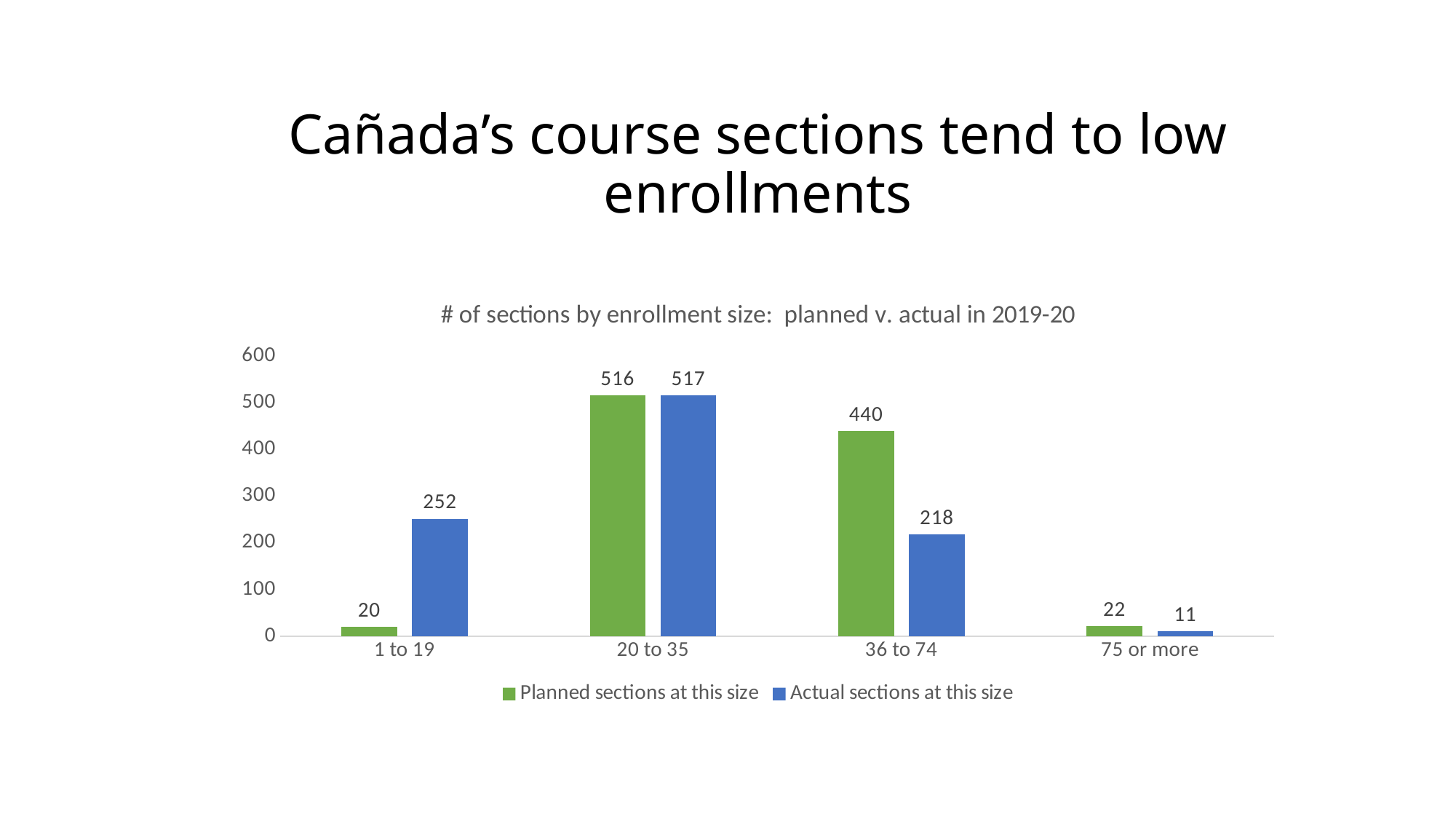
Which enrollment size category has the lowest number of planned sections? 1 to 19 How many enrollment size categories are shown on the x axis? 4 How many series does the legend list? 2 How many actual sections were there at the 1 to 19 enrollment size? 252 What type of chart is shown on the slide? Bar chart How many planned sections were there at the 1 to 19 enrollment size? 20 Which enrollment size category has the highest number of actual sections? 20 to 35 How many actual sections were there at the 36 to 74 enrollment size? 218 What is the difference between planned and actual sections for the 36 to 74 enrollment size? 222 Which is larger for the 75 or more category: planned sections or actual sections? Planned sections at this size What is the title of the chart? # of sections by enrollment size: planned v. actual in 2019-20 What is the difference between actual and planned sections for the 1 to 19 enrollment size? 232